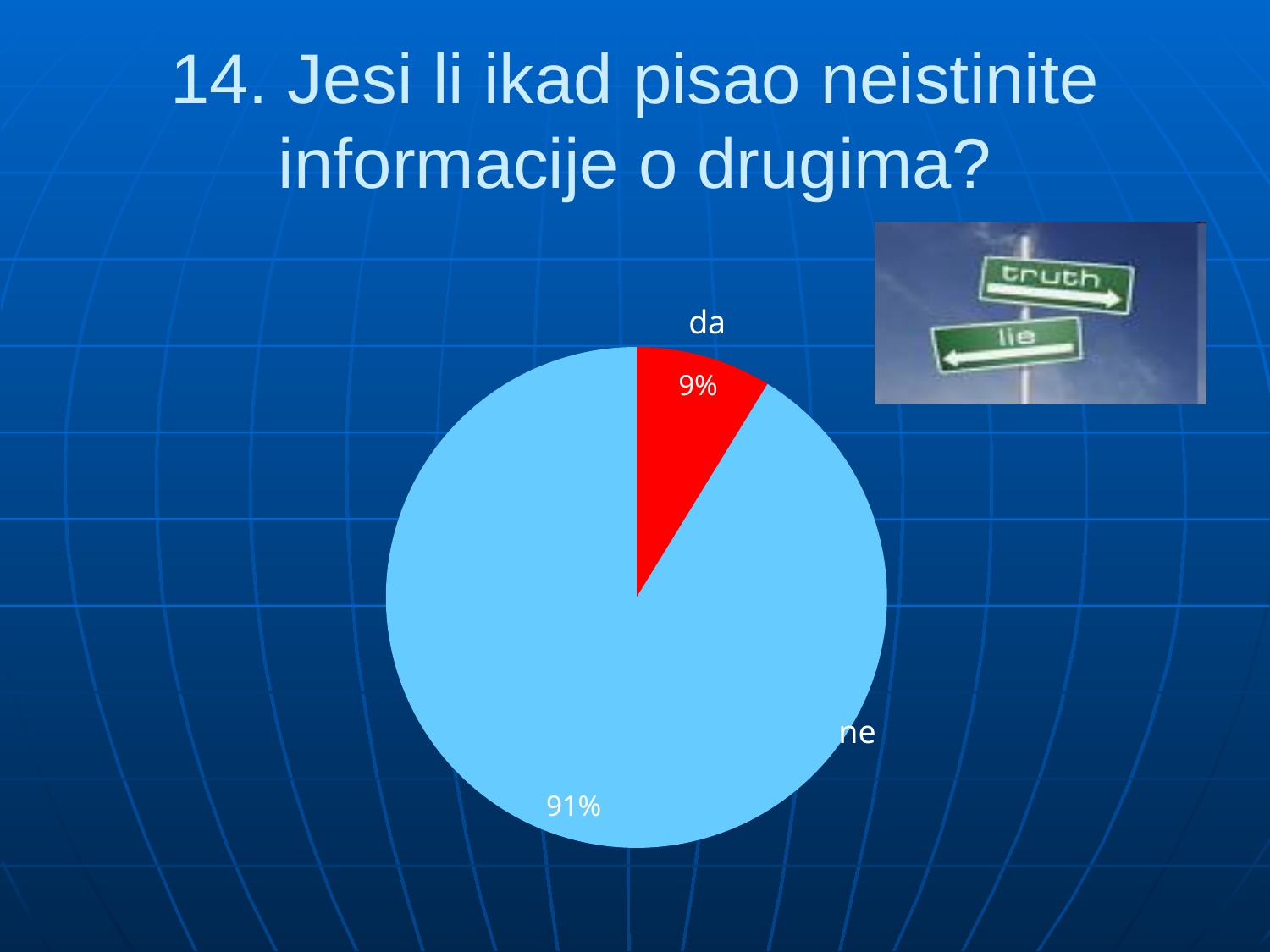
What kind of chart is shown on the slide? pie chart Which slice of the pie is the largest? ne What percentage of the pie is labelled "da"? 9% What colour is the "da" slice of the pie? red What is the difference in percentage points between the "ne" slice and the "da" slice? 82 Which slice of the pie is the smallest? da What share of the pie does the "da" slice represent? 9% Which is larger, the "da" slice or the "ne" slice? ne How many slices does the pie chart have? 2 What percentage of the pie is labelled "ne"? 91% What colour is the "ne" slice of the pie? light blue